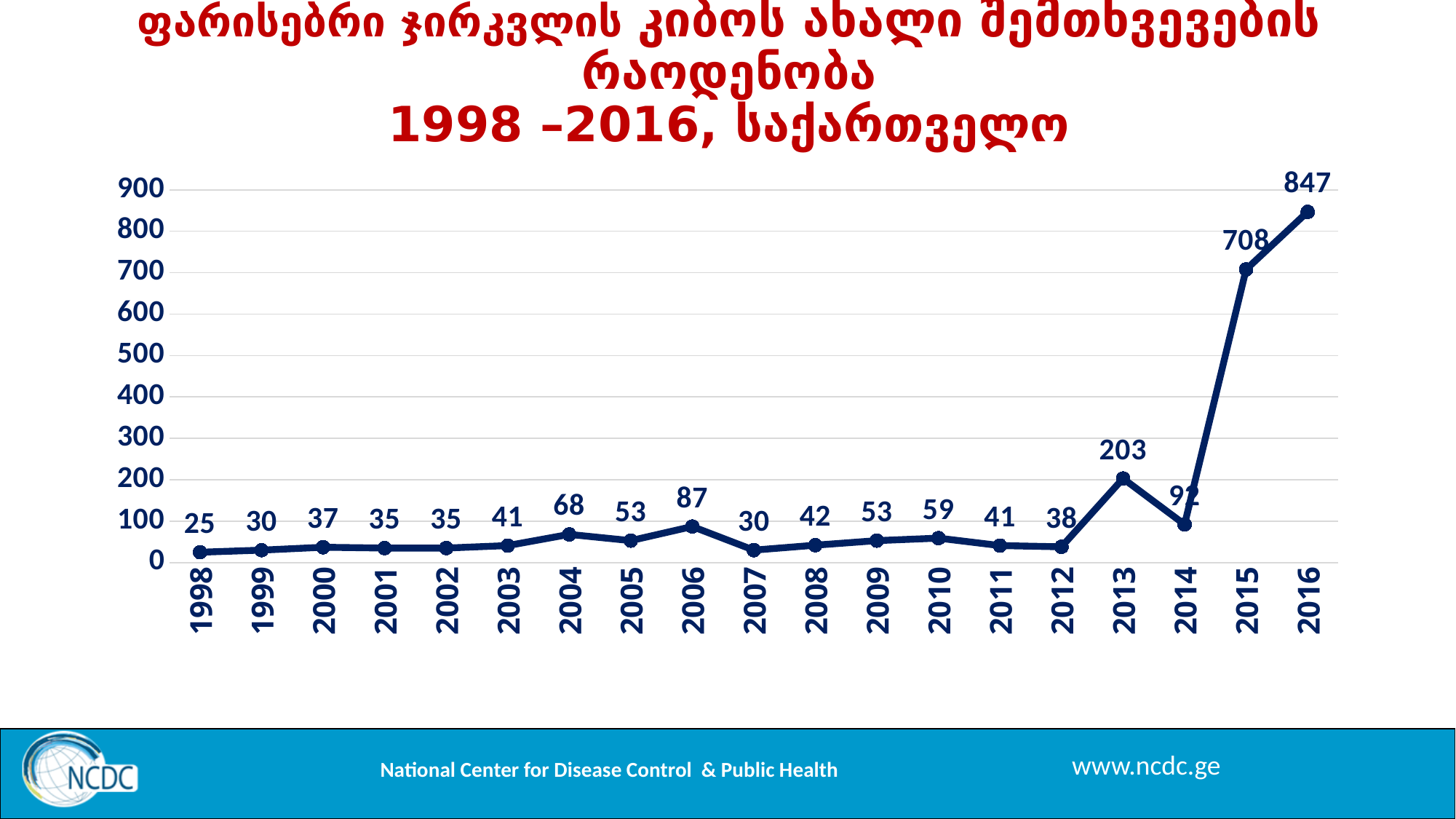
What is the value for 2013? 203 Do the values generally rise or fall from 2012 to 2016? rise What is the value for 2006? 87 What is the value for 2016? 847 What is the value for 1998? 25 How many years are plotted on the x axis? 19 Which year has the highest value? 2016 Which year has the lowest value? 1998 What is the difference between the values for 2016 and 2015? 139 What type of chart is shown on the slide? line chart Which is larger, the value for 2004 or the value for 2006? 2006 Is the value for 2014 greater or less than 200? less